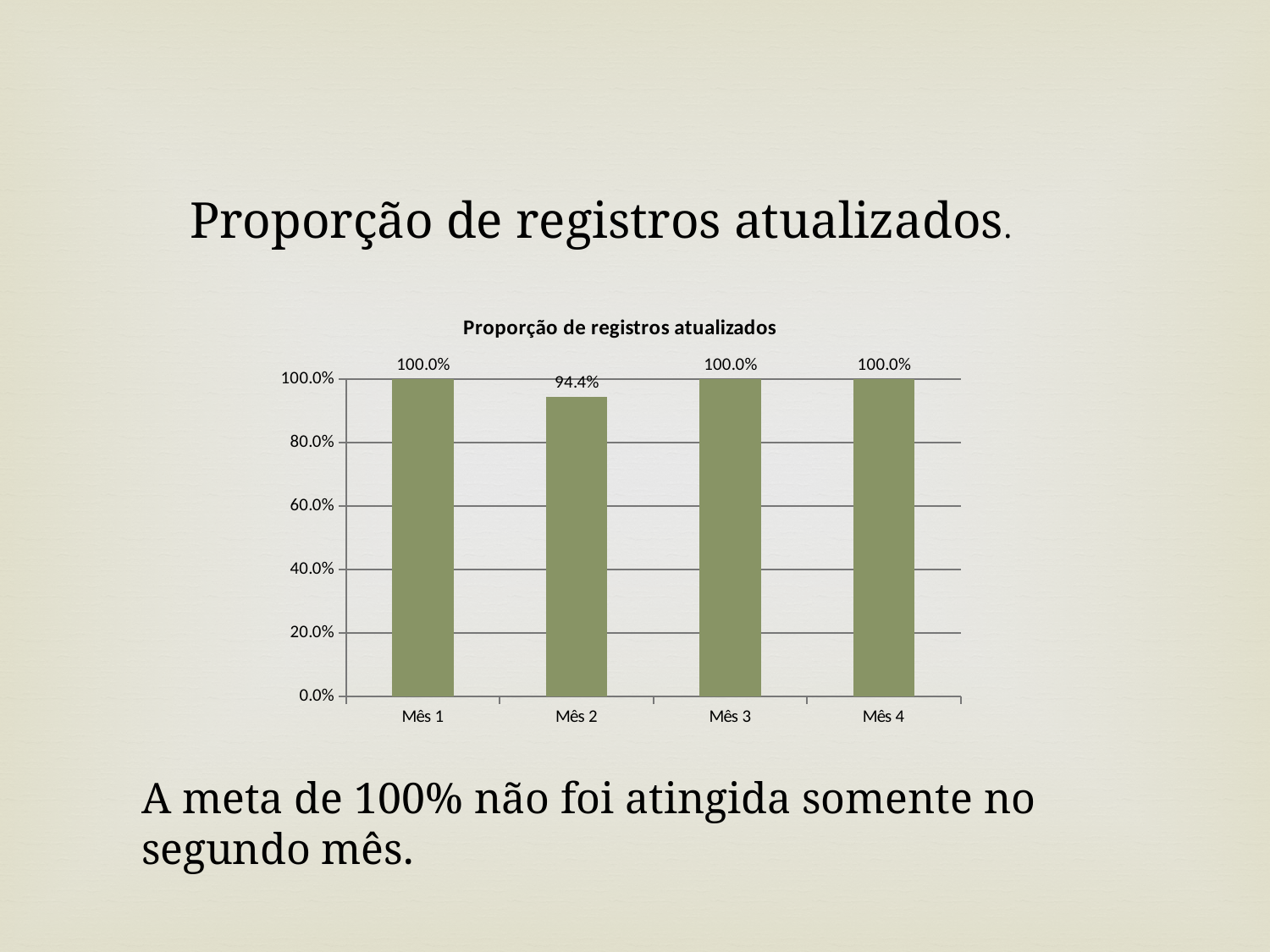
What kind of chart is shown? bar chart What is the title of the chart? Proporção de registros atualizados Which is larger, the value for Mês 2 or the value for Mês 3? Mês 3 What is the value for Mês 1? 100.0% What is the highest value shown on the y axis? 100.0% Which month has the lowest value? Mês 2 What is the value for Mês 2? 94.4% How many months are shown on the x axis? 4 What is the value for Mês 4? 100.0% Is the value for Mês 2 greater or less than 80.0%? greater How many months reach 100.0%? 3 What is the difference between the values for Mês 1 and Mês 2? 5.6%